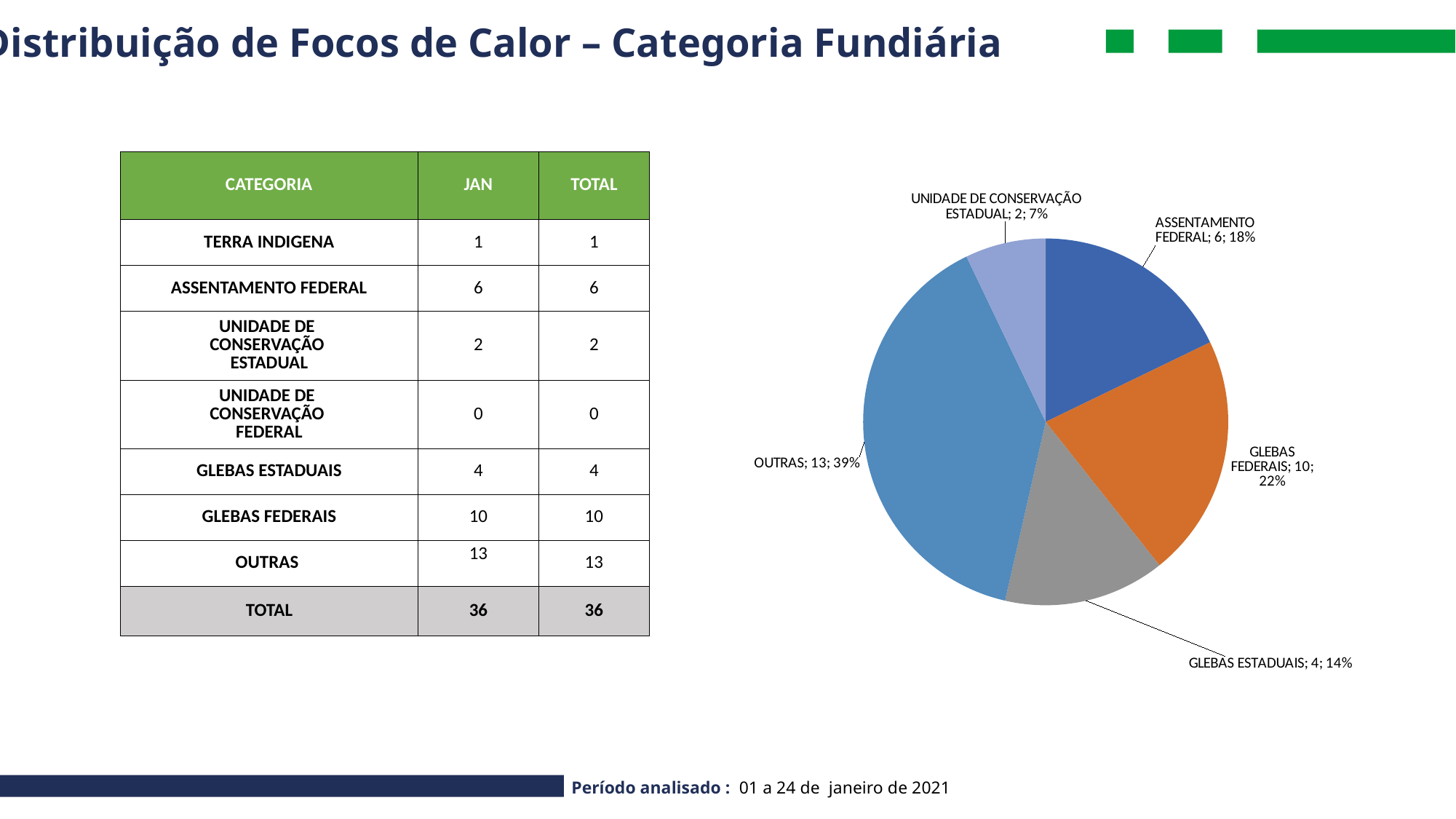
In the pie chart, what value is shown for OUTRAS? 13 In the pie chart, what value is shown for GLEBAS FEDERAIS? 10 Which labeled slice of the pie chart is the largest? OUTRAS In the pie chart, what is the difference between the values for OUTRAS and GLEBAS ESTADUAIS? 9 In the pie chart, what value is shown for ASSENTAMENTO FEDERAL? 6 In the pie chart, which is larger: GLEBAS FEDERAIS or ASSENTAMENTO FEDERAL? GLEBAS FEDERAIS What share of the pie does GLEBAS ESTADUAIS represent? 14% Which labeled slice of the pie chart is the smallest? UNIDADE DE CONSERVAÇÃO ESTADUAL In the pie chart, what value is shown for UNIDADE DE CONSERVAÇÃO ESTADUAL? 2 What share of the pie does OUTRAS represent? 39% What share of the pie does GLEBAS FEDERAIS represent? 22% What kind of chart is shown on the slide? pie chart